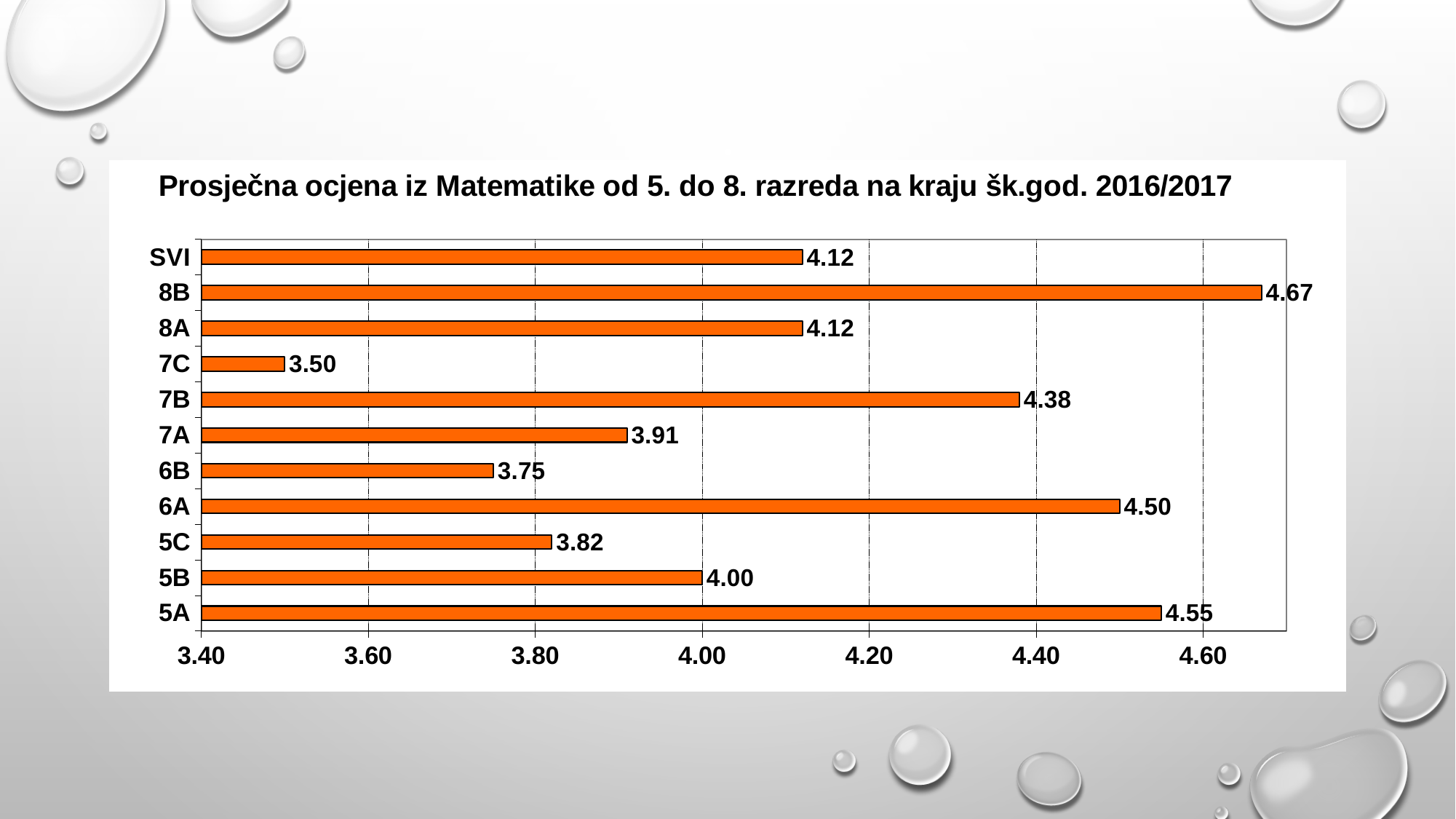
Which class has the highest average Mathematics grade? 8B What is the average grade for class 5B? 4.00 What is the difference between the average grades of 8B and 7C? 1.17 Is the value for 7A greater or less than 4.00? less How many categories are shown on the chart? 11 What is the difference between the values for 6A and 6B? 0.75 Which has a higher average grade, 5A or 7B? 5A What kind of chart is shown on the slide? bar chart Which class has the lowest average Mathematics grade? 7C What is the title of the chart? Prosječna ocjena iz Matematike od 5. do 8. razreda na kraju šk.god. 2016/2017 What is the average Mathematics grade for class 8B? 4.67 What is the value shown for SVI? 4.12